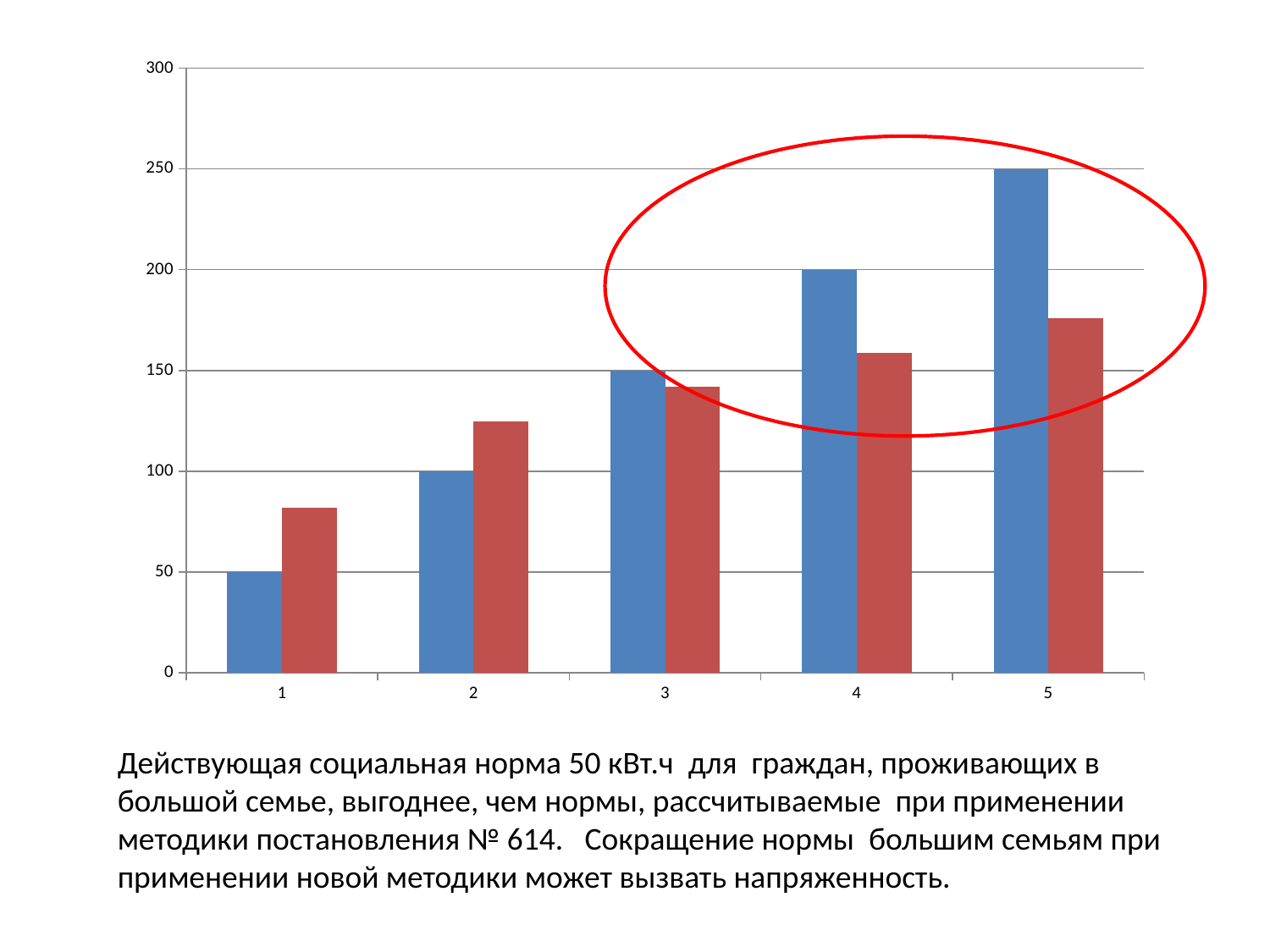
Is the value of the red bar for category 1 greater or less than 100? less Is the value of the red bar for category 2 greater or less than 100? greater What is the value of the blue bar for category 1? 50 What is the value of the blue bar for category 5? 250 For category 5, which bar is taller, the blue one or the red one? blue Is the value of the red bar for category 5 greater or less than 150? greater What kind of chart is shown on the slide? bar chart For category 1, which bar is taller, the blue one or the red one? red Do the blue bars rise or fall from category 1 to category 5? rise What is the difference between the blue bar for category 5 and the blue bar for category 1? 200 What is the value of the blue bar for category 3? 150 How many categories are shown on the x axis of the chart? 5